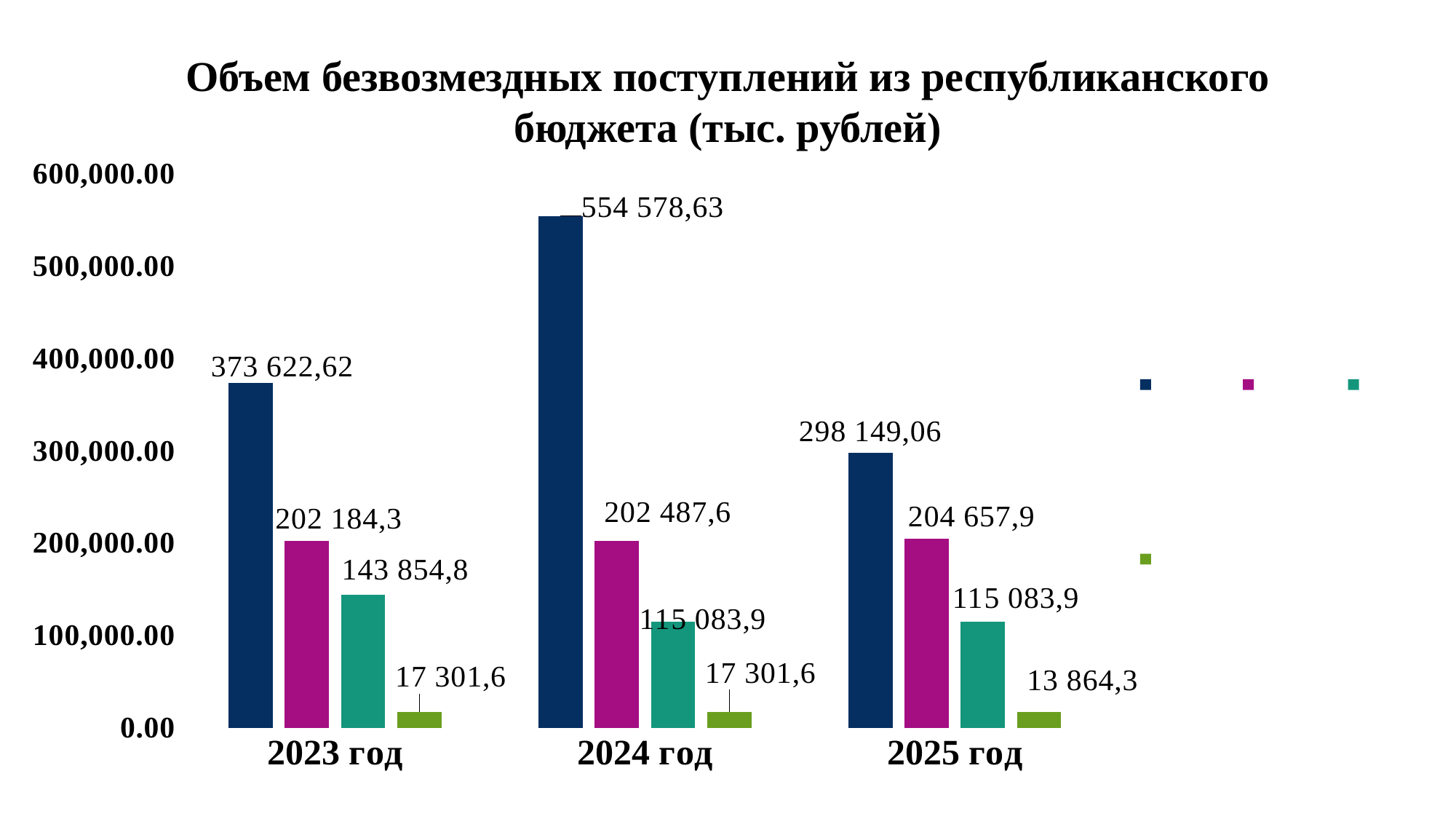
How many series does the legend list? 4 What is the difference between the dark blue bar for 2024 год and the dark blue bar for 2023 год? 180 956,01 In which year is the dark blue bar the lowest? 2025 год What is the value of the green bar for 2025 год? 13 864,3 In which year is the dark blue bar the highest? 2024 год Do the magenta bars rise or fall from 2023 год to 2025 год? rise How many year categories are shown on the x axis? 3 Which is larger: the teal bar for 2023 год or the teal bar for 2024 год? 2023 год What is the value of the dark blue bar for 2024 год? 554 578,63 Is the value of the dark blue bar for 2023 год greater or less than 400,000.00? less What is the value of the magenta bar for 2025 год? 204 657,9 What kind of chart is shown on the slide? bar chart